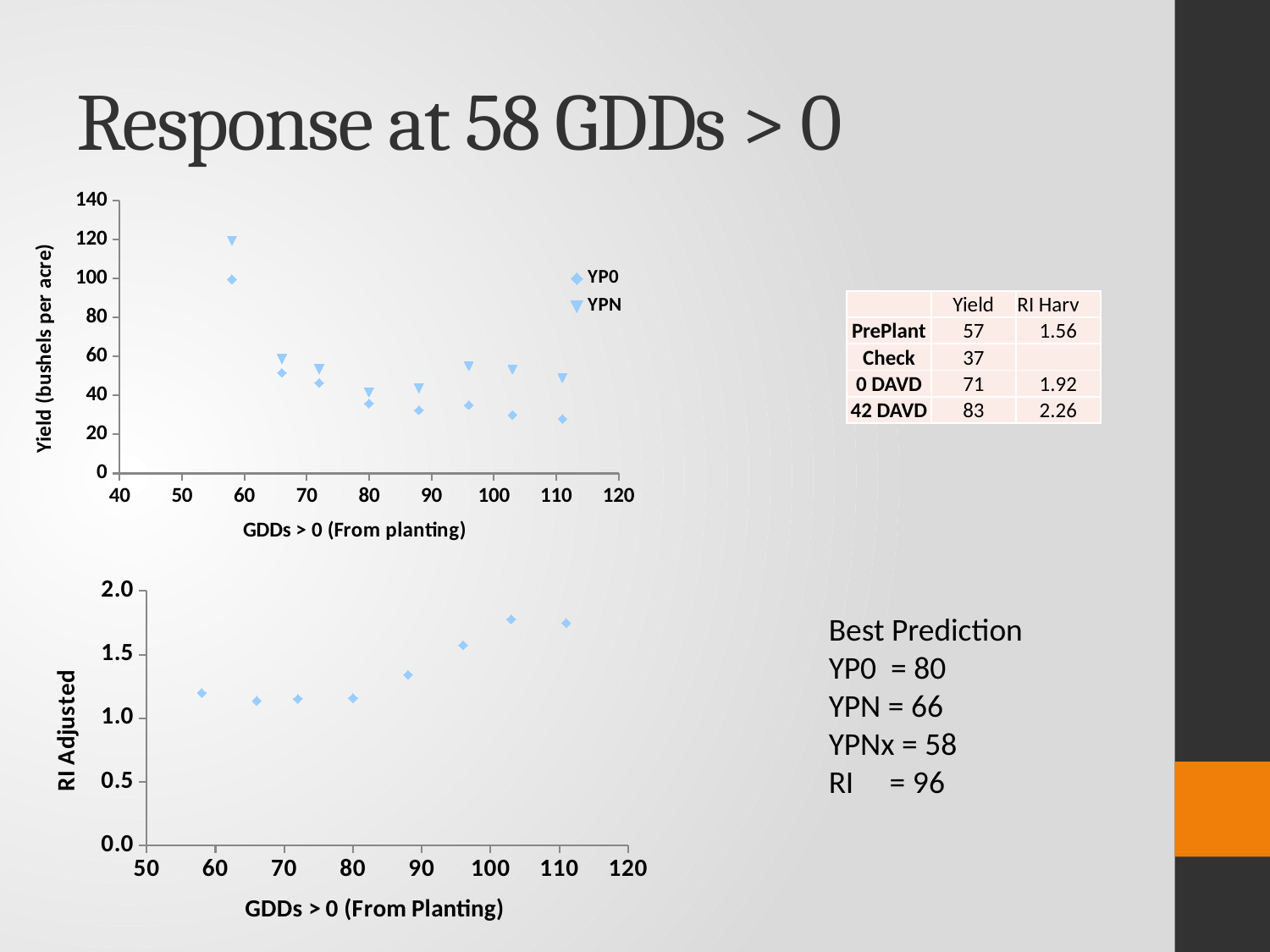
How many series does the legend of the top chart list? 2 In the top chart, is the YP0 value at the rightmost point (around 111 GDDs) greater or less than 40? less In the top chart, do the YP0 values generally rise or fall as GDDs > 0 increase? fall What kind of chart is the top chart (Yield vs GDDs > 0)? scatter chart In the bottom chart, is the RI Adjusted value at around 103 GDDs greater or less than 1.5? greater What kind of chart is the bottom chart (RI Adjusted vs GDDs > 0)? scatter chart In the top chart, at the leftmost point (around 58 GDDs), which series has the larger yield, YP0 or YPN? YPN In the top chart, is the YPN value at the leftmost point (around 58 GDDs) greater or less than 100? greater In the bottom chart, do the RI Adjusted values generally rise or fall as GDDs > 0 increase? rise In the top chart, how many data points are plotted for the YP0 series? 8 What are the two series named in the legend of the top chart? YP0 and YPN How many data points are plotted in the bottom chart? 8